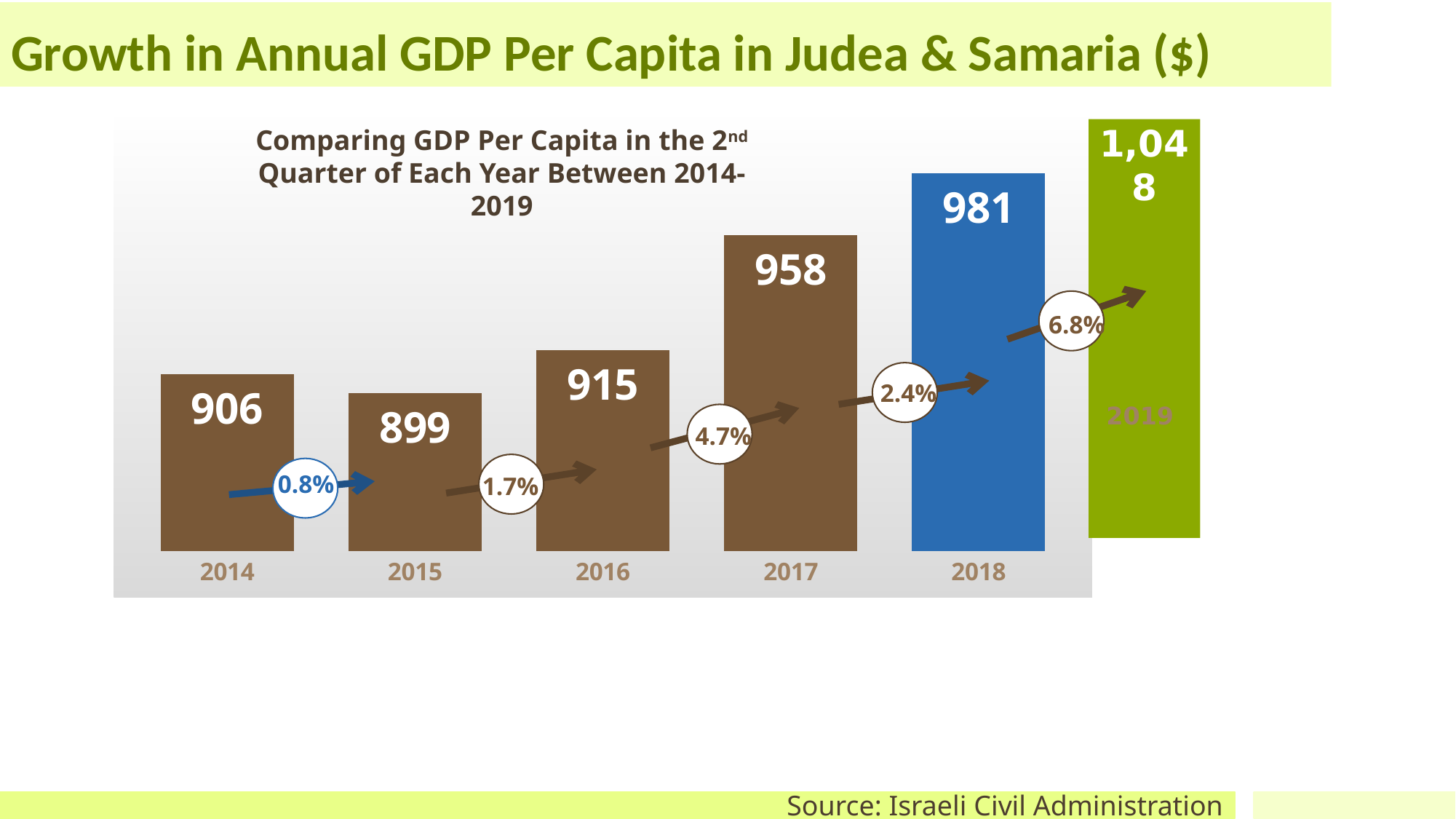
What percentage growth is shown between 2018 and 2019? 6.8% Which year has the lowest GDP per capita value? 2015 What is the GDP per capita value shown for 2014? 906 Do the values generally rise or fall from 2015 to 2019? rise What is the GDP per capita value shown for 2018? 981 How many years are shown in the chart? 6 What is the GDP per capita value shown for 2017? 958 Which year has the highest GDP per capita value? 2019 Which is larger, the value for 2014 or the value for 2015? 2014 What kind of chart is this? bar chart What is the GDP per capita value shown for 2019? 1,048 What is the difference between the 2018 and 2017 values? 23